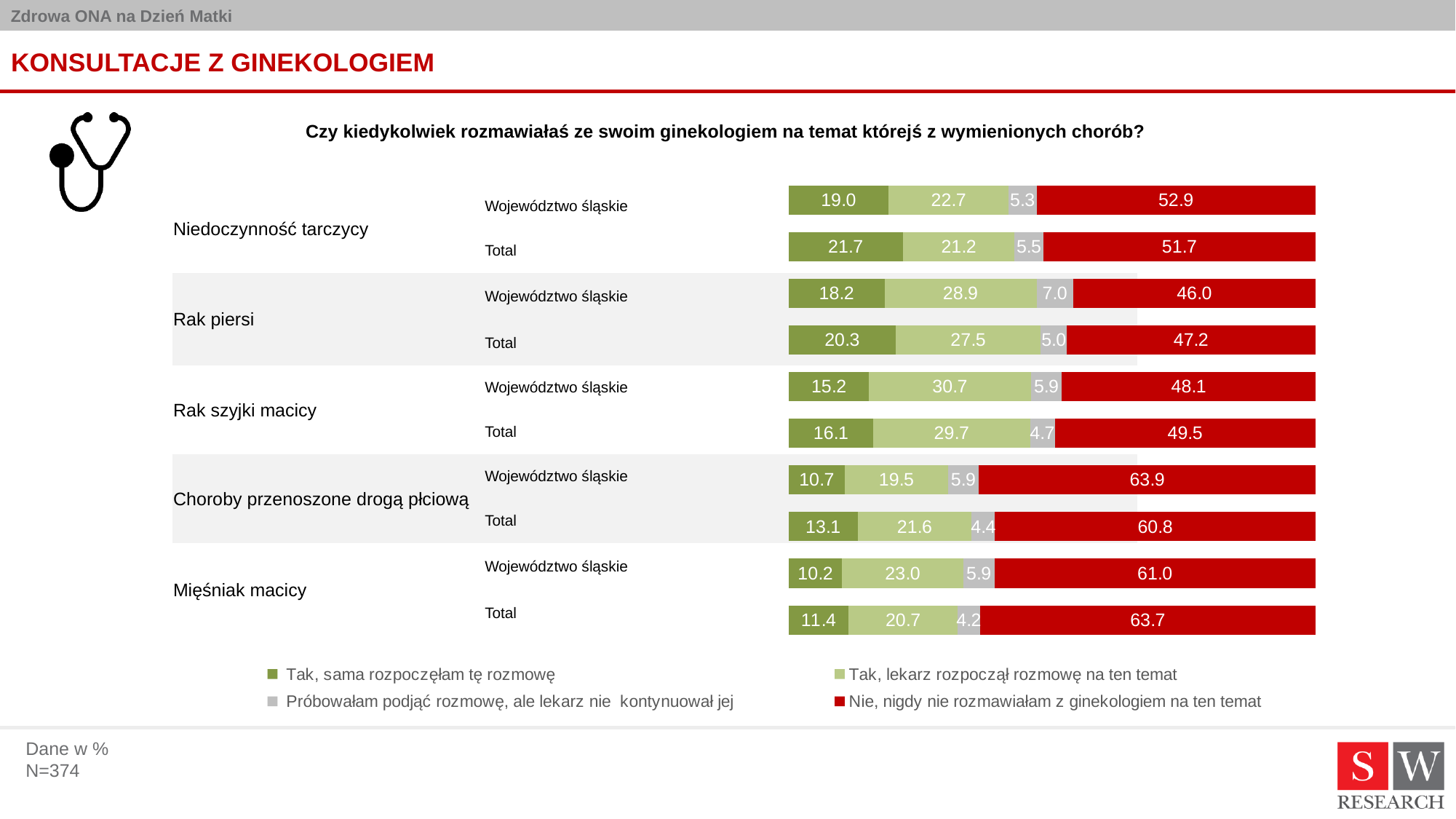
For Mięśniak macicy, what is the Total value for "Tak, sama rozpoczęłam tę rozmowę"? 11.4 What is the Województwo śląskie value for "Próbowałam podjąć rozmowę, ale lekarz nie kontynuował jej" for Rak piersi? 7.0 What kind of chart is shown on the slide? Stacked bar chart For Rak piersi, what is the difference between the Total and Województwo śląskie values for "Nie, nigdy nie rozmawiałam z ginekologiem na ten temat"? 1.2 For Rak piersi, what is the Total value for "Tak, lekarz rozpoczął rozmowę na ten temat"? 27.5 For Rak szyjki macicy, which is larger for "Tak, lekarz rozpoczął rozmowę na ten temat": Województwo śląskie or Total? Województwo śląskie Which bar has the highest value for "Nie, nigdy nie rozmawiałam z ginekologiem na ten temat"? Choroby przenoszone drogą płciową, Województwo śląskie How many series does the legend list? 4 Which bar has the lowest value for "Tak, sama rozpoczęłam tę rozmowę"? Mięśniak macicy, Województwo śląskie How many bars are shown in the chart? 10 For Niedoczynność tarczycy, what is the difference between the Total and Województwo śląskie values for "Tak, sama rozpoczęłam tę rozmowę"? 2.7 What percentage of respondents from Województwo śląskie answered "Nie, nigdy nie rozmawiałam z ginekologiem na ten temat" for Niedoczynność tarczycy? 52.9